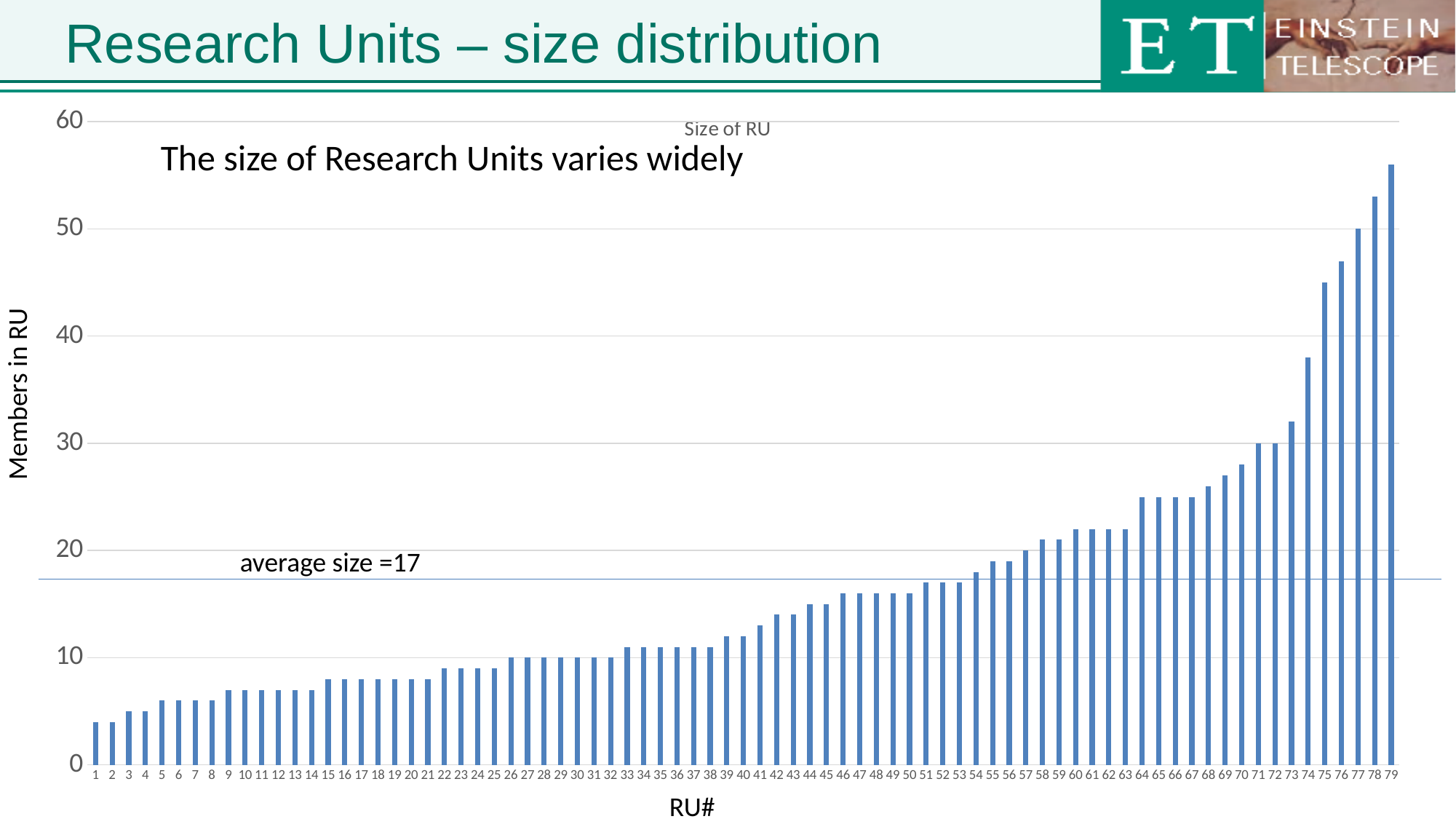
Is the value for RU# 74 greater or less than 40? less What kind of chart is shown on the slide? bar chart Is the value for RU# 64 greater or less than 20? greater What is the title of the chart? Size of RU Which has more members, RU# 79 or RU# 1? RU# 79 Is the value for RU# 1 greater or less than 10? less Which RU# has the highest number of members? 79 How many members does RU# 77 have? 50 How many Research Units (RU#) are plotted along the x axis? 79 Do the values rise or fall as RU# increases along the x axis? rise What average size is annotated on the chart? 17